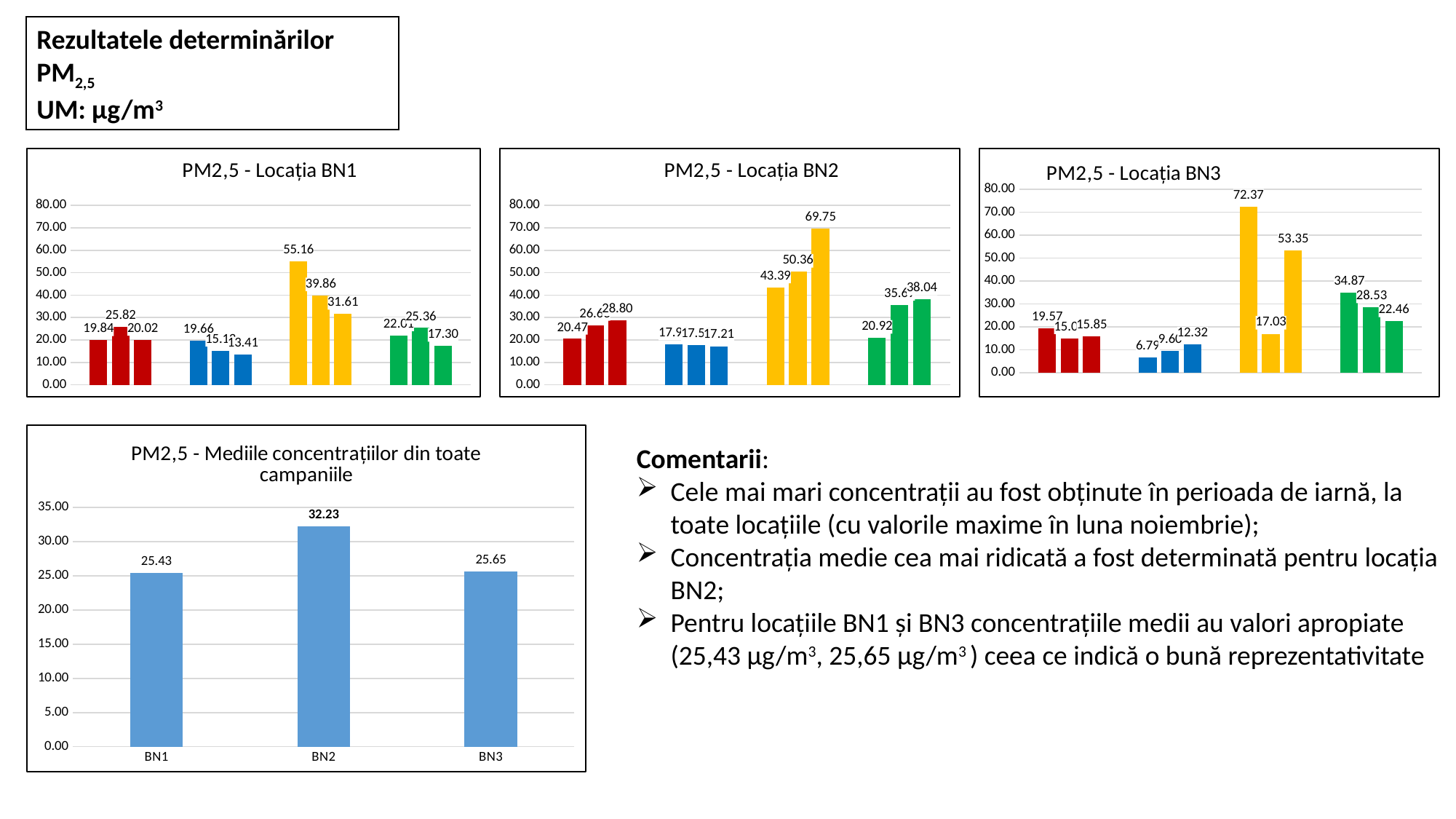
How many bars are shown in the chart 'PM2,5 - Mediile concentrațiilor din toate campaniile'? 3 In the chart 'PM2,5 - Locația BN3', what is the highest value labeled? 72.37 In the chart 'PM2,5 - Mediile concentrațiilor din toate campaniile', what is the difference between the values for BN2 and BN1? 6.80 In the chart 'PM2,5 - Mediile concentrațiilor din toate campaniile', what is the value for BN2? 32.23 In the chart 'PM2,5 - Locația BN2', what is the highest value labeled? 69.75 In the chart 'PM2,5 - Locația BN1', what is the highest value labeled? 55.16 In the chart 'PM2,5 - Mediile concentrațiilor din toate campaniile', what is the value for BN1? 25.43 What kind of chart is 'PM2,5 - Mediile concentrațiilor din toate campaniile'? bar chart In the chart 'PM2,5 - Mediile concentrațiilor din toate campaniile', which location has the lowest value? BN1 In the chart 'PM2,5 - Mediile concentrațiilor din toate campaniile', what is the value for BN3? 25.65 Which is larger: the highest value in the chart 'PM2,5 - Locația BN3' or the highest value in the chart 'PM2,5 - Locația BN2'? PM2,5 - Locația BN3